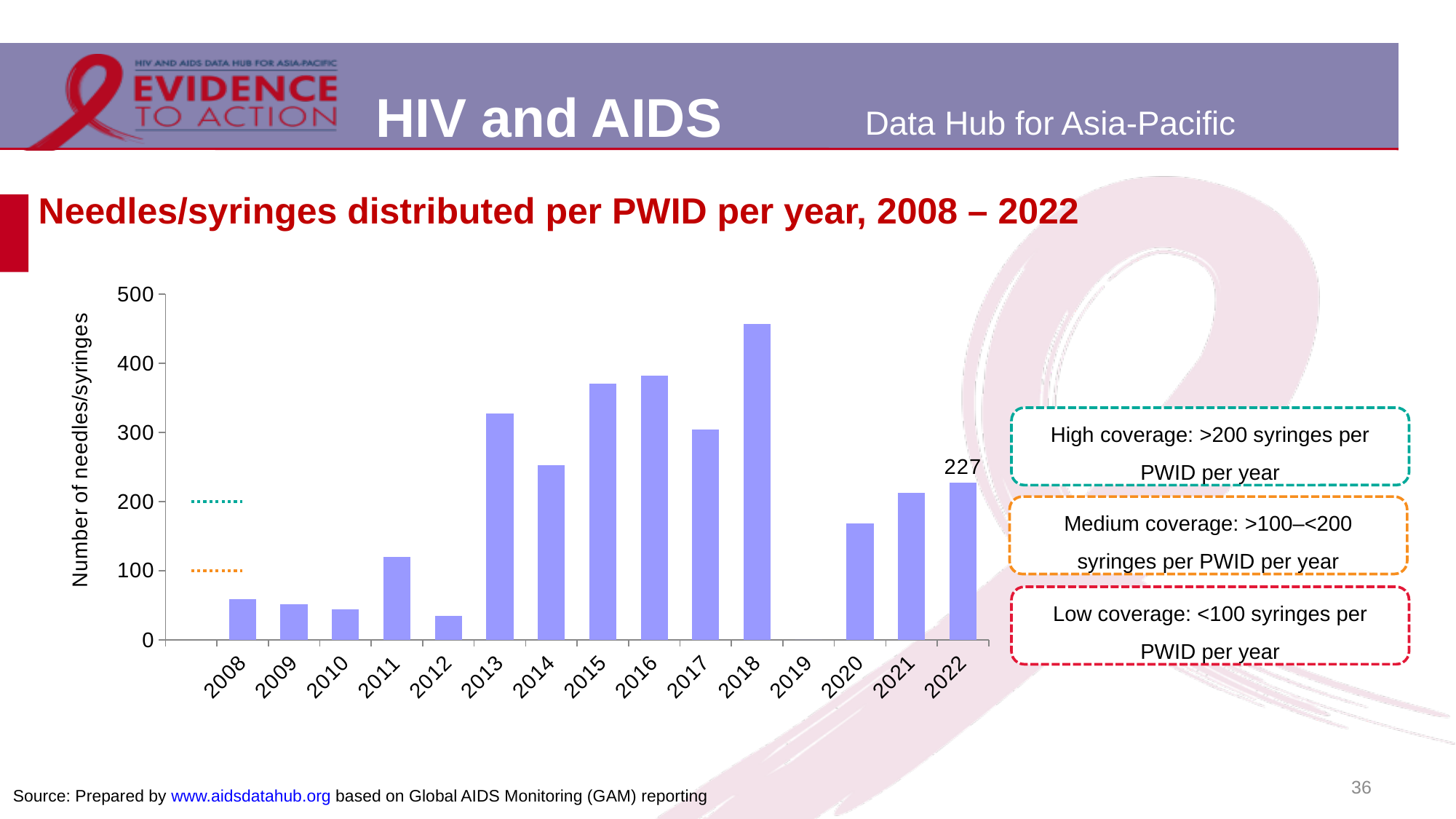
Which year on the x axis has no bar plotted? 2019 Which year has the highest number of needles/syringes distributed per PWID? 2018 How many years are labeled on the x axis? 15 Is the value for 2018 greater or less than 400? greater Is the value for 2020 greater or less than 200? less Is the value for 2011 greater or less than 100? greater What kind of chart is shown on the slide? Bar chart What is the value shown for 2022? 227 Which year has a larger value, 2020 or 2021? 2021 Do the values rise or fall from 2020 to 2022? Rise Which year has a larger value, 2013 or 2014? 2013 Which year has the lowest bar in the chart? 2012